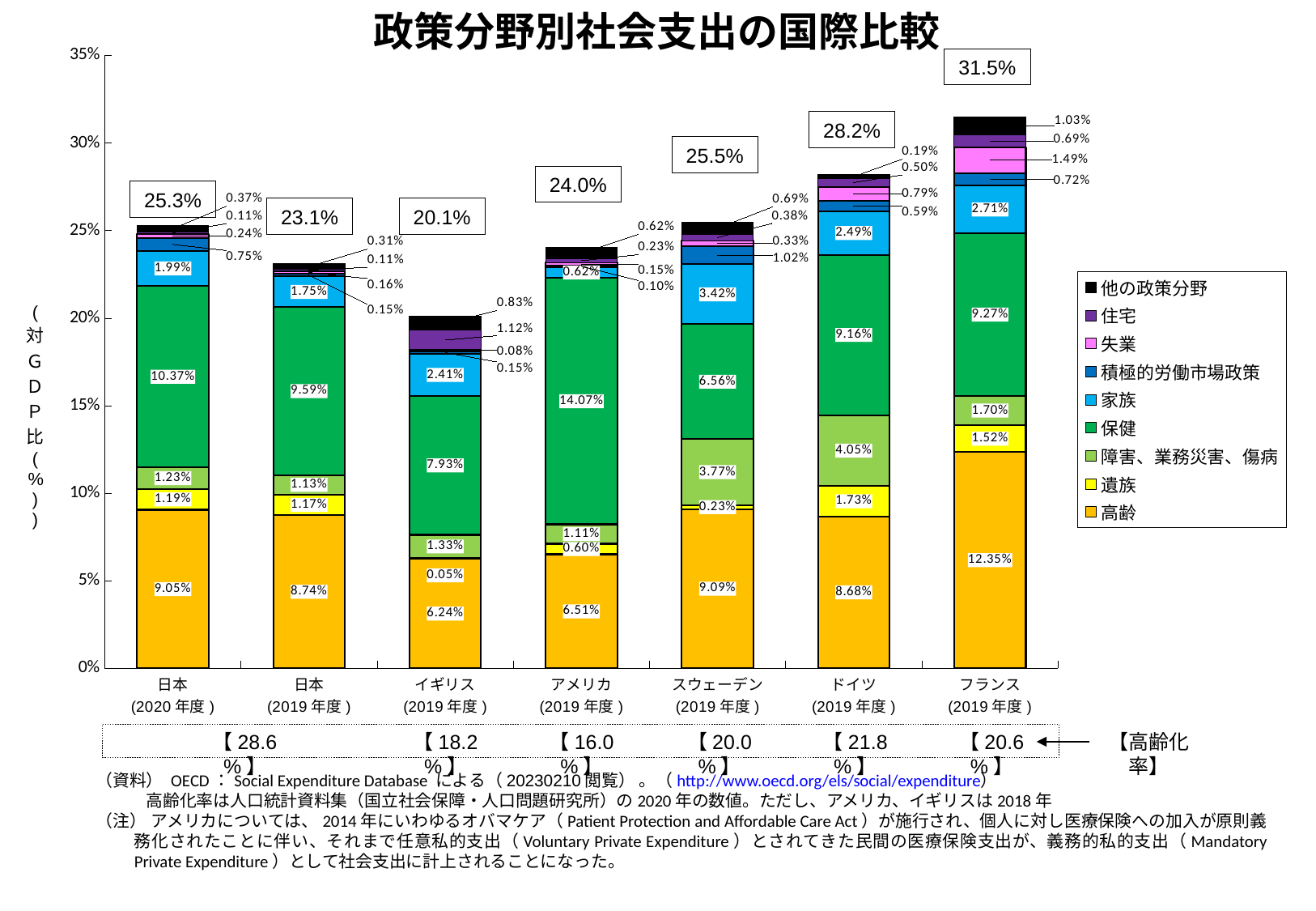
What is the total social expenditure (% of GDP) shown above the bar for フランス (2019年度)? 31.5% What is the value of the 家族 segment for スウェーデン (2019年度)? 3.42% How many country/year bars are shown in the chart? 7 Which has a larger 保健 segment, アメリカ (2019年度) or 日本 (2020年度)? アメリカ (2019年度) What type of chart is shown on the slide? Stacked bar chart What is the difference between the total for フランス (2019年度) and the total for 日本 (2020年度)? 6.2 percentage points What is the value of the 保健 segment for アメリカ (2019年度)? 14.07% Which country/year bar has the lowest total social expenditure? イギリス (2019年度) Which country/year bar has the highest total social expenditure? フランス (2019年度) Is the total for 日本 (2019年度) greater or less than 25%? less What is the value of the 高齢 segment for フランス (2019年度)? 12.35% How many series does the legend list? 9